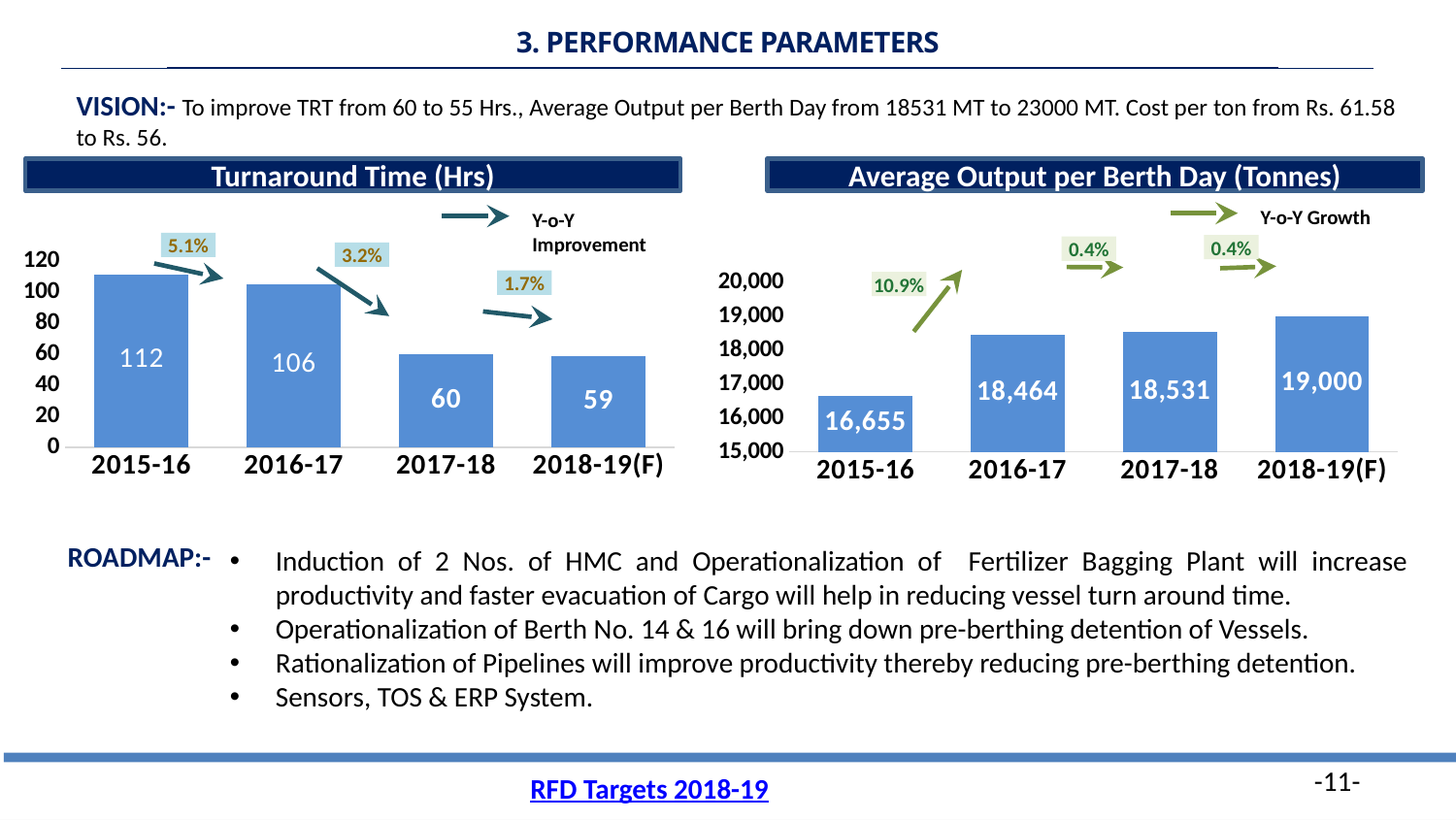
In the Turnaround Time (Hrs) chart, do the values rise or fall from 2015-16 to 2018-19(F)? fall In the Turnaround Time (Hrs) chart, what is the value for 2018-19(F)? 59 In the Average Output per Berth Day (Tonnes) chart, what is the difference between the 2018-19(F) and 2017-18 values? 469 In the Average Output per Berth Day (Tonnes) chart, what is the value for 2016-17? 18,464 In the Turnaround Time (Hrs) chart, which year has the highest value? 2015-16 In the Average Output per Berth Day (Tonnes) chart, which year has the lowest value? 2015-16 In the Average Output per Berth Day (Tonnes) chart, is the value for 2017-18 larger or smaller than the value for 2016-17? larger In the Turnaround Time (Hrs) chart, what is the difference between the 2016-17 and 2017-18 values? 46 In the Turnaround Time (Hrs) chart, what is the value for 2015-16? 112 In the Turnaround Time (Hrs) chart, how many years are plotted? 4 In the Average Output per Berth Day (Tonnes) chart, what is the value for 2015-16? 16,655 What type of chart is the Average Output per Berth Day (Tonnes) chart? bar chart